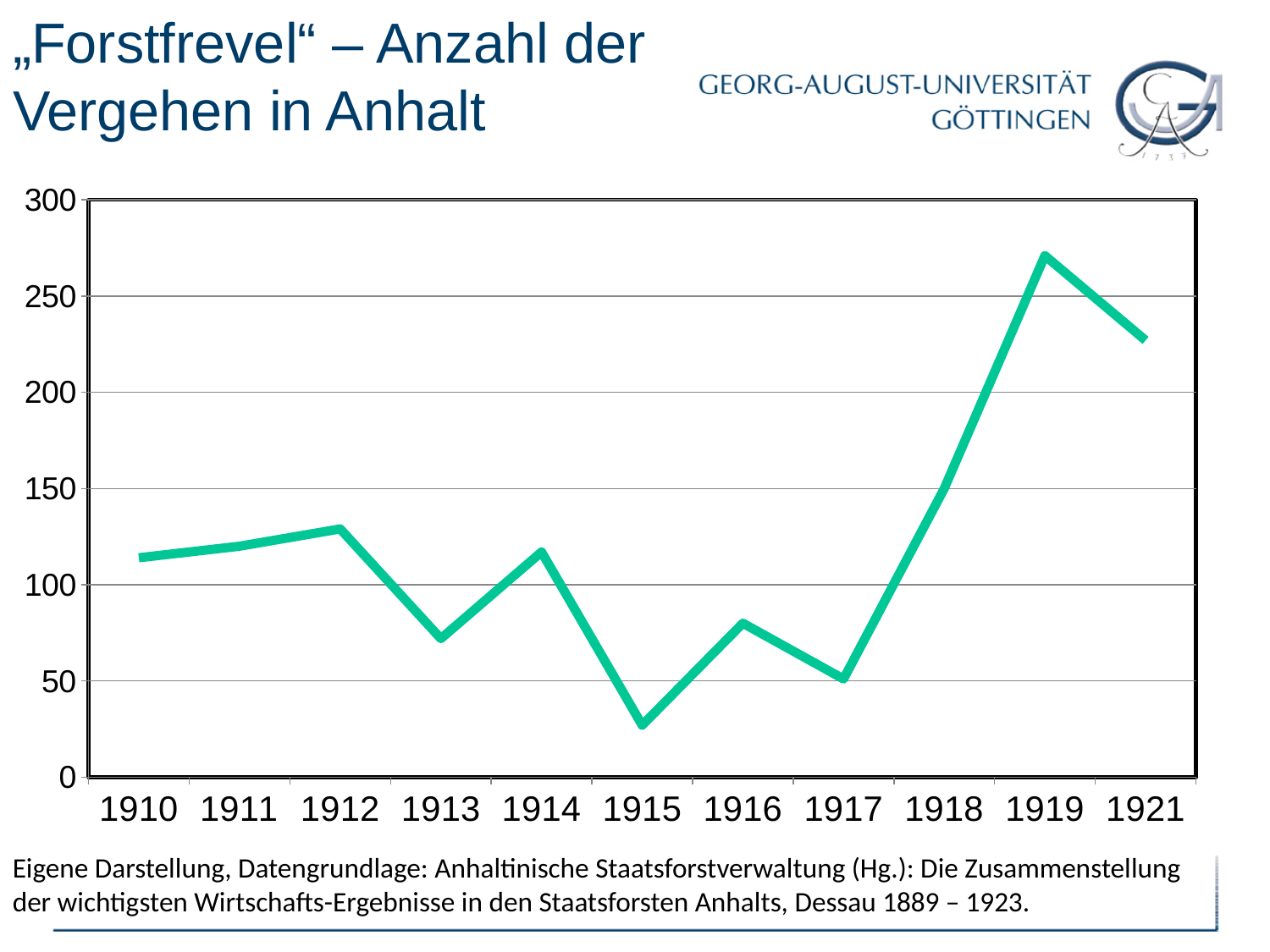
How many years are plotted on the x axis of the chart? 11 Which year has the lowest number of offences in the chart? 1915 What kind of chart is shown on the slide? line chart Is the value for 1919 greater or less than 250? greater Which year has the larger value, 1919 or 1921? 1919 Which year has the highest number of offences in the chart? 1919 Does the line rise or fall from 1917 to 1919? rise Is the value for 1915 greater or less than 50? less Is the value for 1921 greater or less than 200? greater Which year has the larger value, 1912 or 1913? 1912 What is the title of the slide containing the chart? „Forstfrevel“ – Anzahl der Vergehen in Anhalt